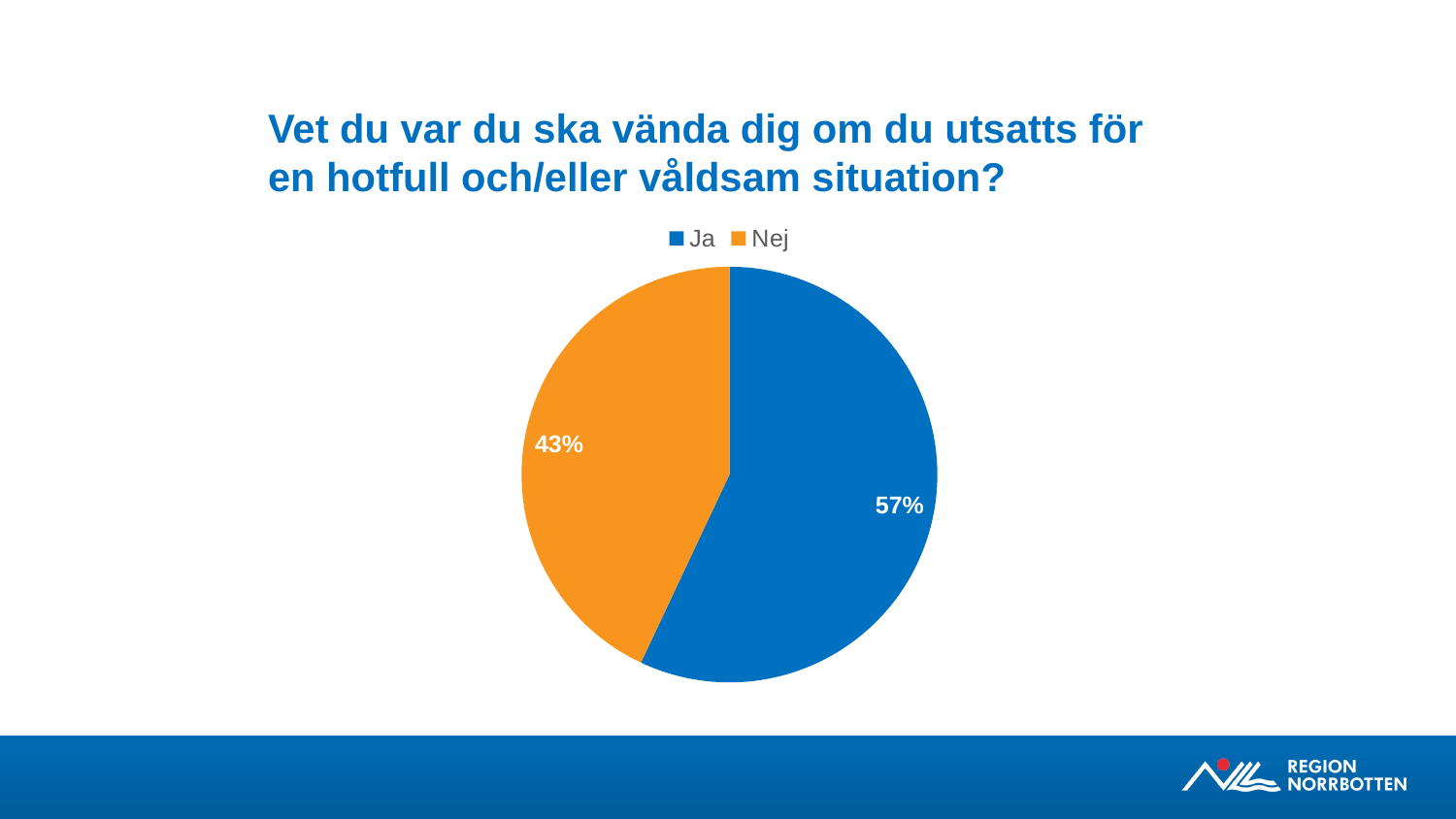
What colour is the "Nej" slice? Orange Which response has the smallest share of the pie? Nej What is the difference in percentage points between the "Ja" and "Nej" shares? 14 How many slices does the pie chart have? 2 What kind of chart is shown on the slide? Pie chart What percentage of respondents answered "Nej"? 43% Which response has the largest share of the pie? Ja What share of the pie does the "Nej" slice represent? 43% What percentage of respondents answered "Ja"? 57% What colour is the "Ja" slice? Blue Which is larger, the share for "Ja" or the share for "Nej"? Ja How many entries does the legend list? 2